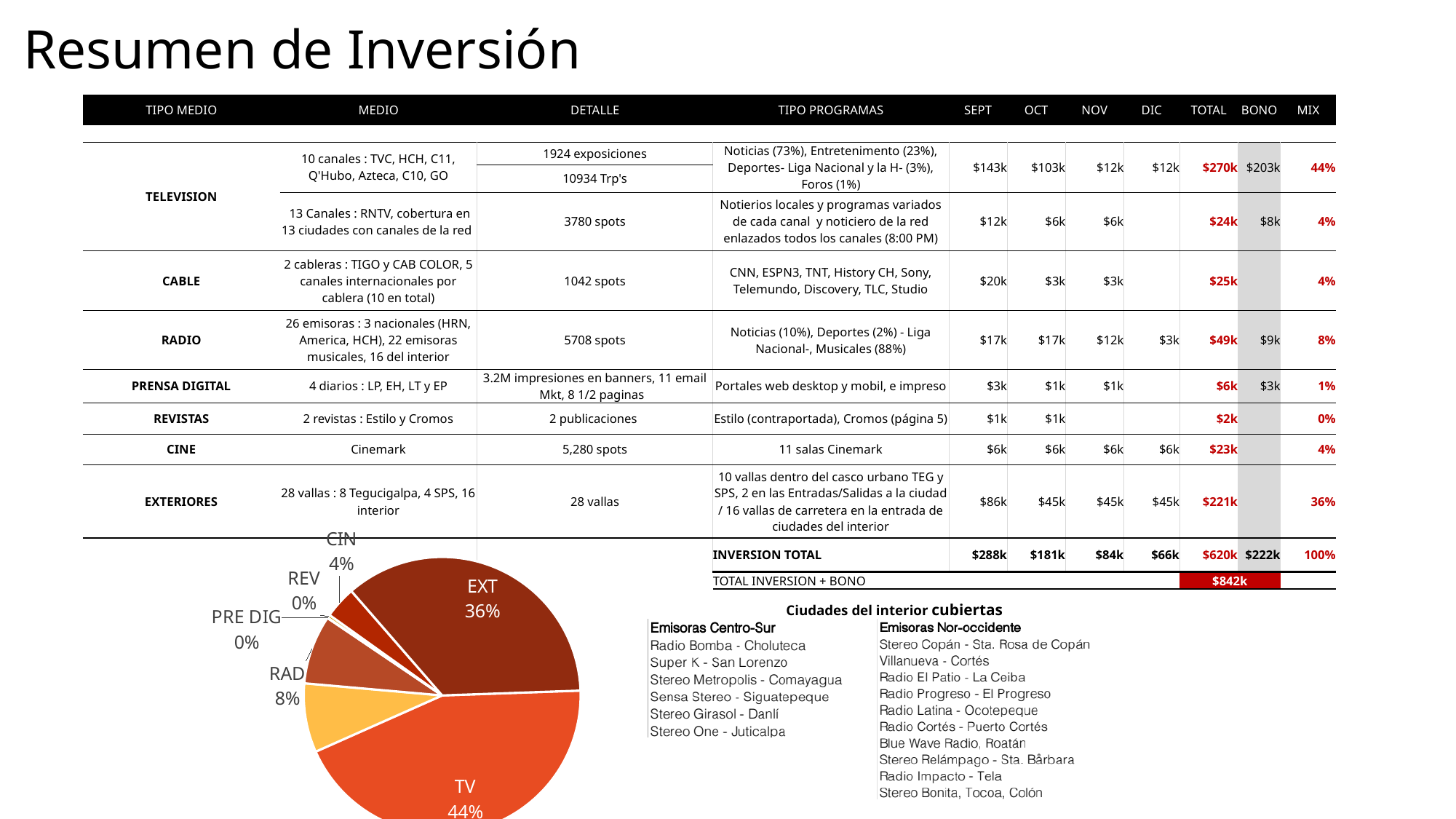
What kind of chart is shown at the bottom left of the slide? pie chart In the pie chart, what share is labelled for REV? 0% In the pie chart, what share is labelled for PRE DIG? 0% In the pie chart, what share is labelled for CIN? 4% Which slice of the pie chart has the largest share? TV In the pie chart, what share is labelled for EXT? 36% In the pie chart, what share is labelled for RAD? 8% In the pie chart, which is larger, the RAD slice or the CIN slice? RAD In the pie chart, what is the difference between the TV share and the EXT share? 8% In the pie chart, what share is labelled for TV? 44% In the pie chart, which is larger, the TV slice or the EXT slice? TV In the pie chart, what colour is the EXT slice? dark brown-red